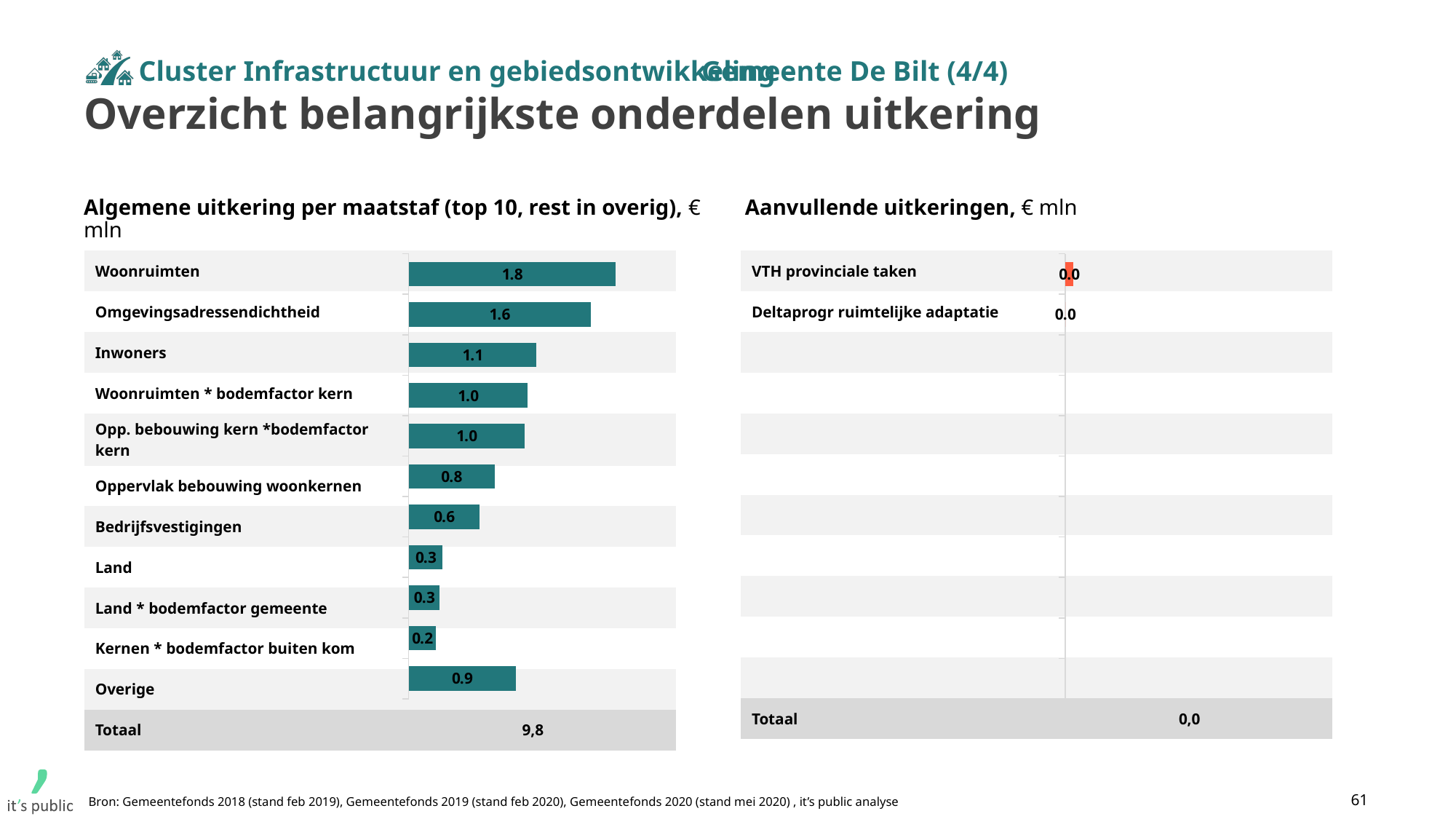
In the chart 'Algemene uitkering per maatstaf', which category has the highest value? Woonruimten In the chart 'Algemene uitkering per maatstaf', how many bars are shown (excluding the Totaal row)? 11 In the chart 'Algemene uitkering per maatstaf', which category has the lowest value? Kernen * bodemfactor buiten kom In the chart 'Aanvullende uitkeringen', what is the value for VTH provinciale taken? 0.0 In the chart 'Algemene uitkering per maatstaf', what is the difference between Woonruimten and Omgevingsadressendichtheid? 0.2 In the chart 'Algemene uitkering per maatstaf', what is the value for Bedrijfsvestigingen? 0.6 In the chart 'Algemene uitkering per maatstaf', what is the Totaal value shown? 9,8 What type of chart is 'Algemene uitkering per maatstaf'? Bar chart In the chart 'Aanvullende uitkeringen', what is the Totaal value shown? 0,0 In the chart 'Algemene uitkering per maatstaf', what is the value for Woonruimten? 1.8 In the chart 'Algemene uitkering per maatstaf', what is the value for Inwoners? 1.1 In the chart 'Algemene uitkering per maatstaf', which is larger: Oppervlak bebouwing woonkernen or Overige? Overige